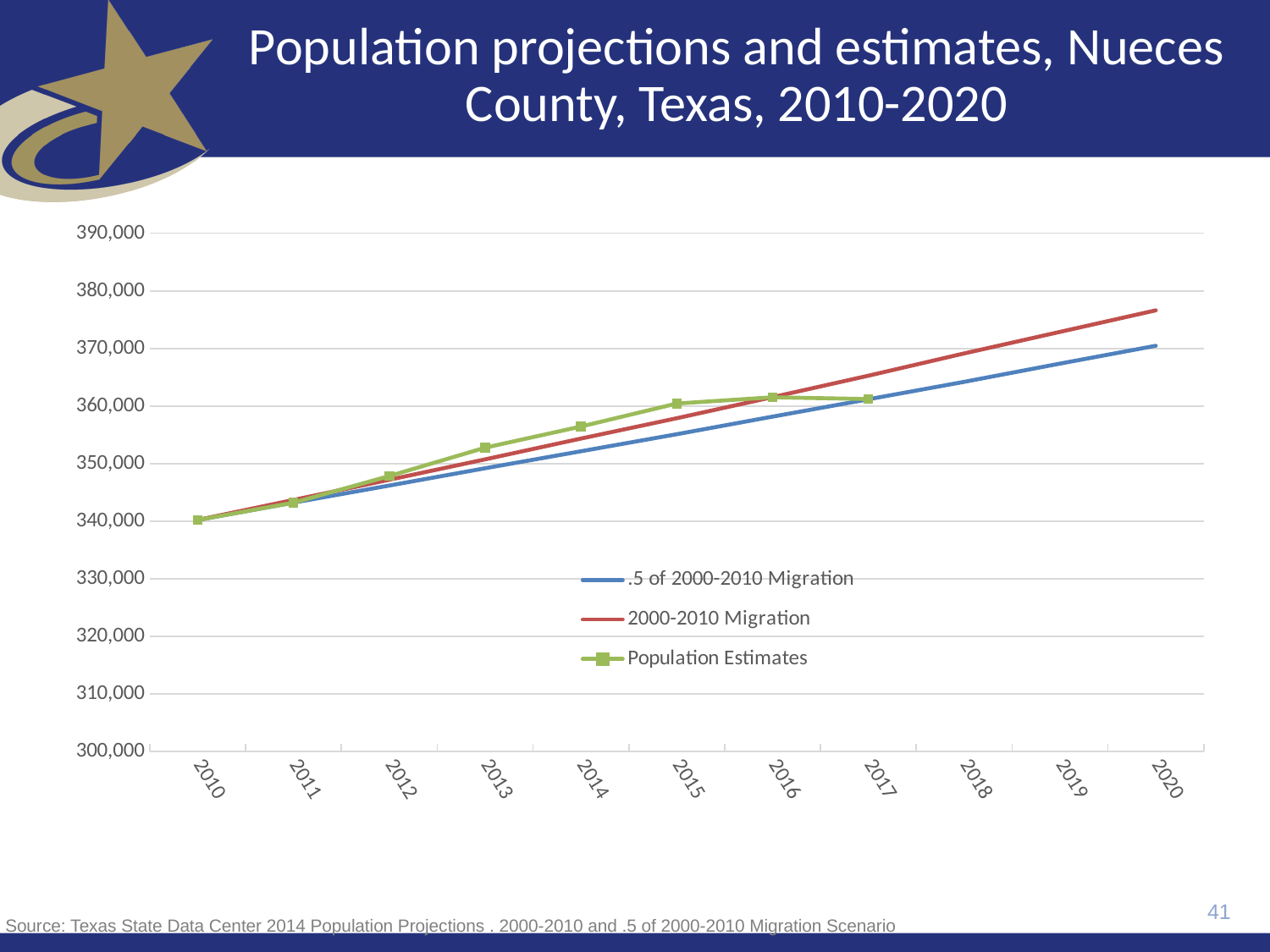
In 2015, which is larger: Population Estimates or .5 of 2000-2010 Migration? Population Estimates What is the last year for which the Population Estimates series has a data point? 2017 In 2020, which is larger: 2000-2010 Migration or .5 of 2000-2010 Migration? 2000-2010 Migration What kind of chart is shown on the slide? line chart Is the value for .5 of 2000-2010 Migration in 2018 greater or less than 370,000? less How many years are shown along the x axis? 11 Is the value for Population Estimates in 2014 greater or less than 350,000? greater Is the value for 2000-2010 Migration in 2020 greater or less than 370,000? greater How many series does the legend list? 3 Do the values for the 2000-2010 Migration series rise or fall from 2010 to 2020? rise Which series has the highest value in 2020? 2000-2010 Migration What is the title of the chart on the slide? Population projections and estimates, Nueces County, Texas, 2010-2020